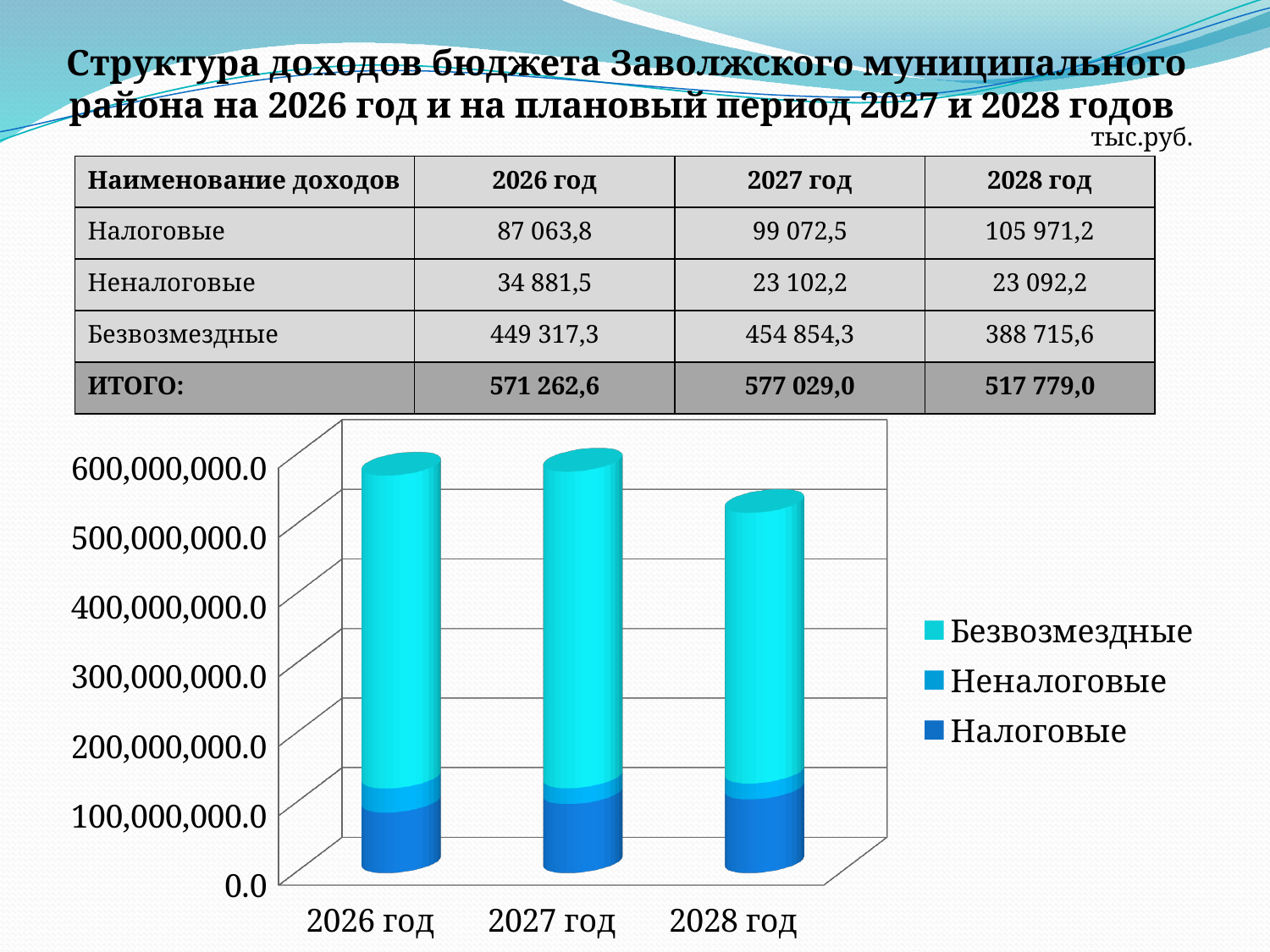
Which total bar is taller, 2027 год or 2028 год? 2027 год Is the total bar for 2028 год greater or less than 600,000,000.0? less Is the total bar for 2028 год greater or less than 500,000,000.0? greater Which year has the lowest total bar in the chart? 2028 год Which series is listed first (at the top) in the chart legend? Безвозмездные Is the total bar for 2026 год greater or less than 500,000,000.0? greater How many years (categories) are plotted on the x axis of the chart? 3 Which series forms the bottom segment of each stacked bar? Налоговые What kind of chart is shown on the slide? stacked bar chart How many series does the chart legend list? 3 Does the total bar rise or fall from 2027 год to 2028 год? fall